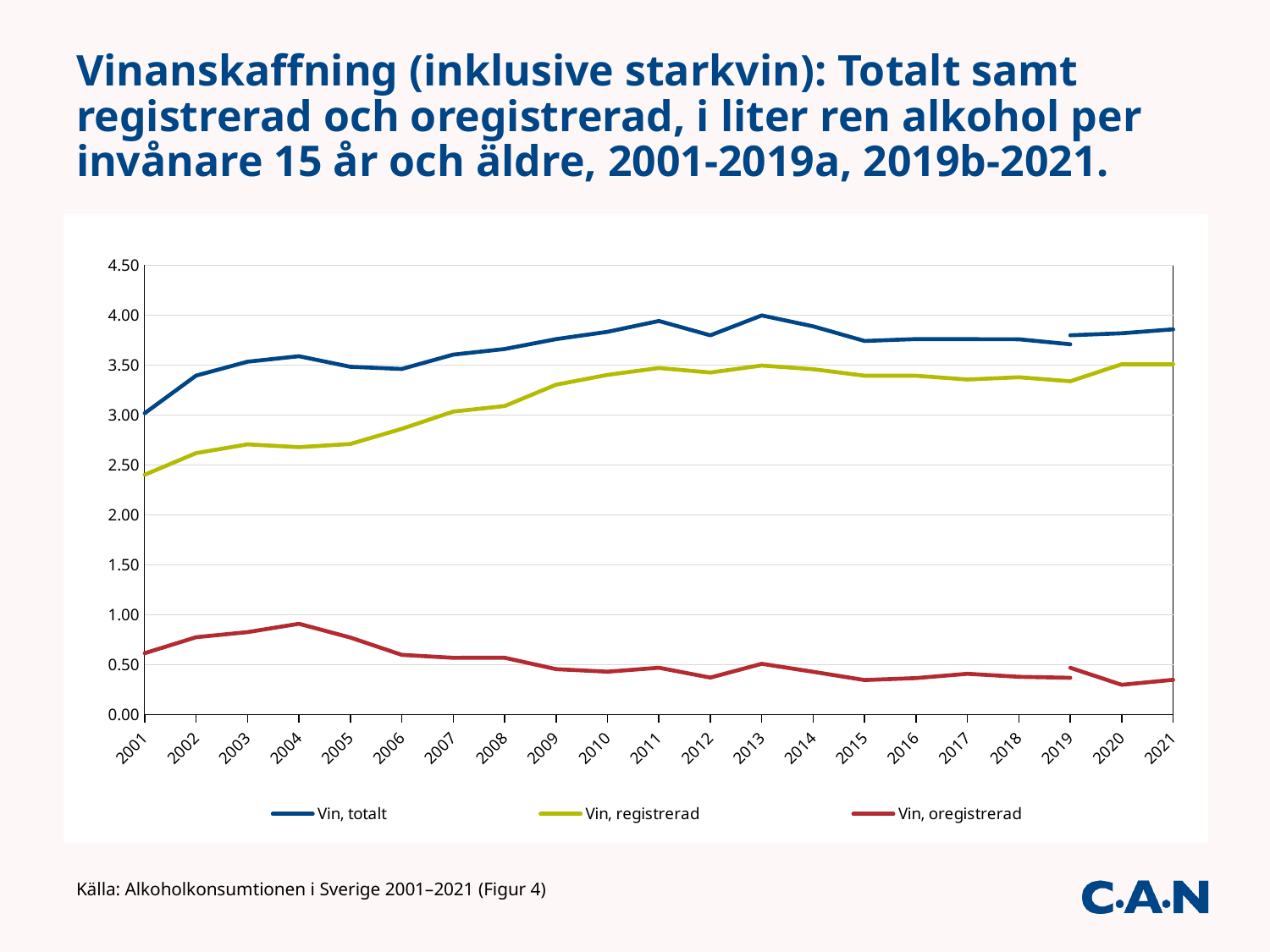
What kind of chart is shown on the slide? Line chart Is the value for Vin, totalt in 2013 greater or less than 3.50? greater Is the value for Vin, totalt in 2001 greater or less than 3.50? less Which is larger for Vin, registrerad: the value in 2001 or the value in 2021? 2021 In which year does the Vin, registrerad line have its lowest value? 2001 Is the value for Vin, oregistrerad in 2004 greater or less than 0.50? greater How many series does the legend list? 3 What colour is the Vin, totalt line? Blue Does the Vin, oregistrerad line rise or fall between 2004 and 2012? Fall In which year does the Vin, oregistrerad line reach its highest value? 2004 How many years are labelled along the x axis? 21